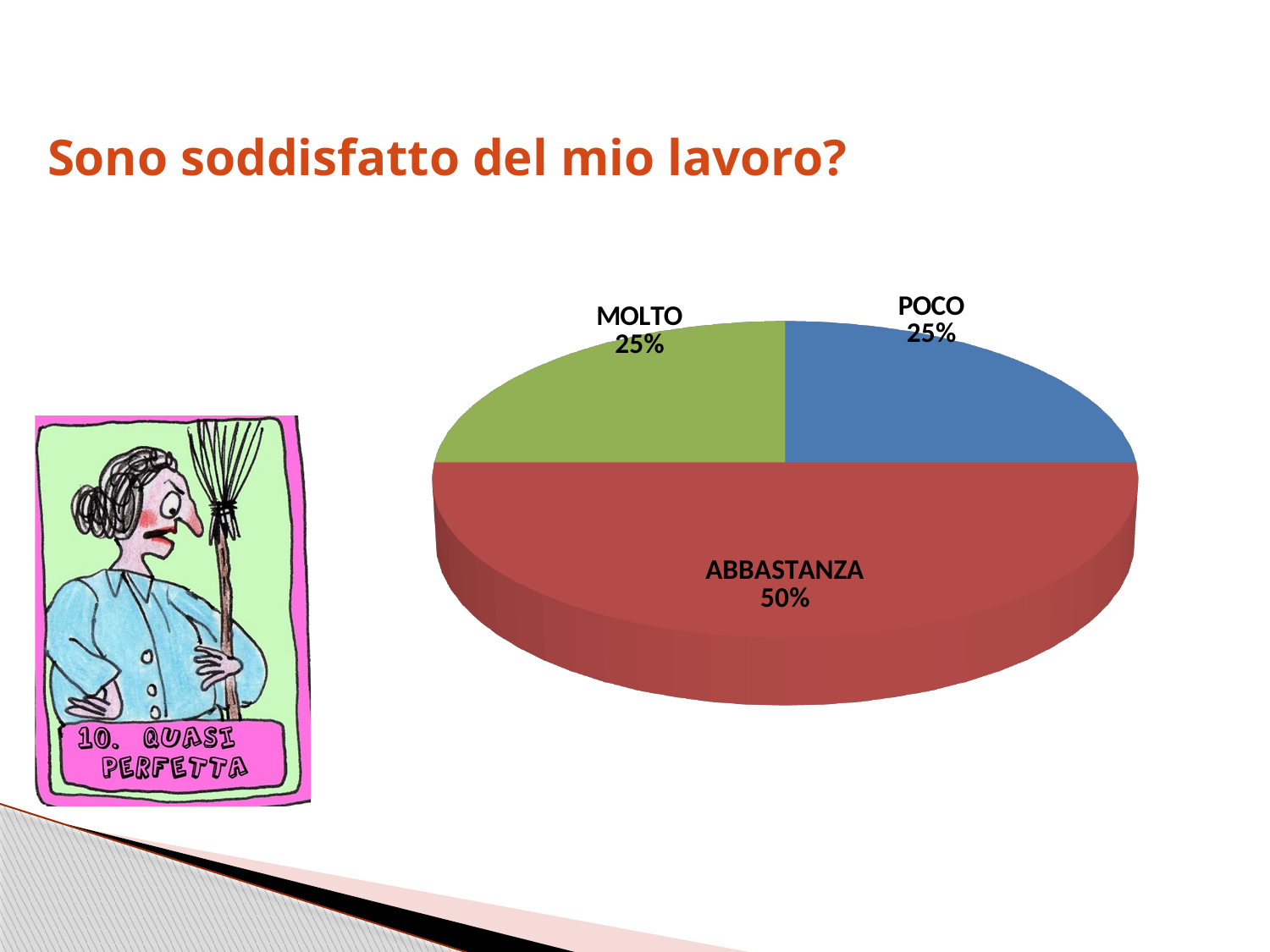
What share of the pie does MOLTO have? 25% What is the title of the slide containing the pie chart? Sono soddisfatto del mio lavoro? What is the combined share of MOLTO and POCO? 50% What kind of chart is shown on the slide? pie chart How many slices does the pie chart have? 3 What is the difference between the ABBASTANZA share and the MOLTO share? 25% Which is larger, the ABBASTANZA slice or the POCO slice? ABBASTANZA Which category has the largest slice of the pie? ABBASTANZA What colour is the ABBASTANZA slice? red What share of the pie does ABBASTANZA have? 50% What share of the pie does POCO have? 25%